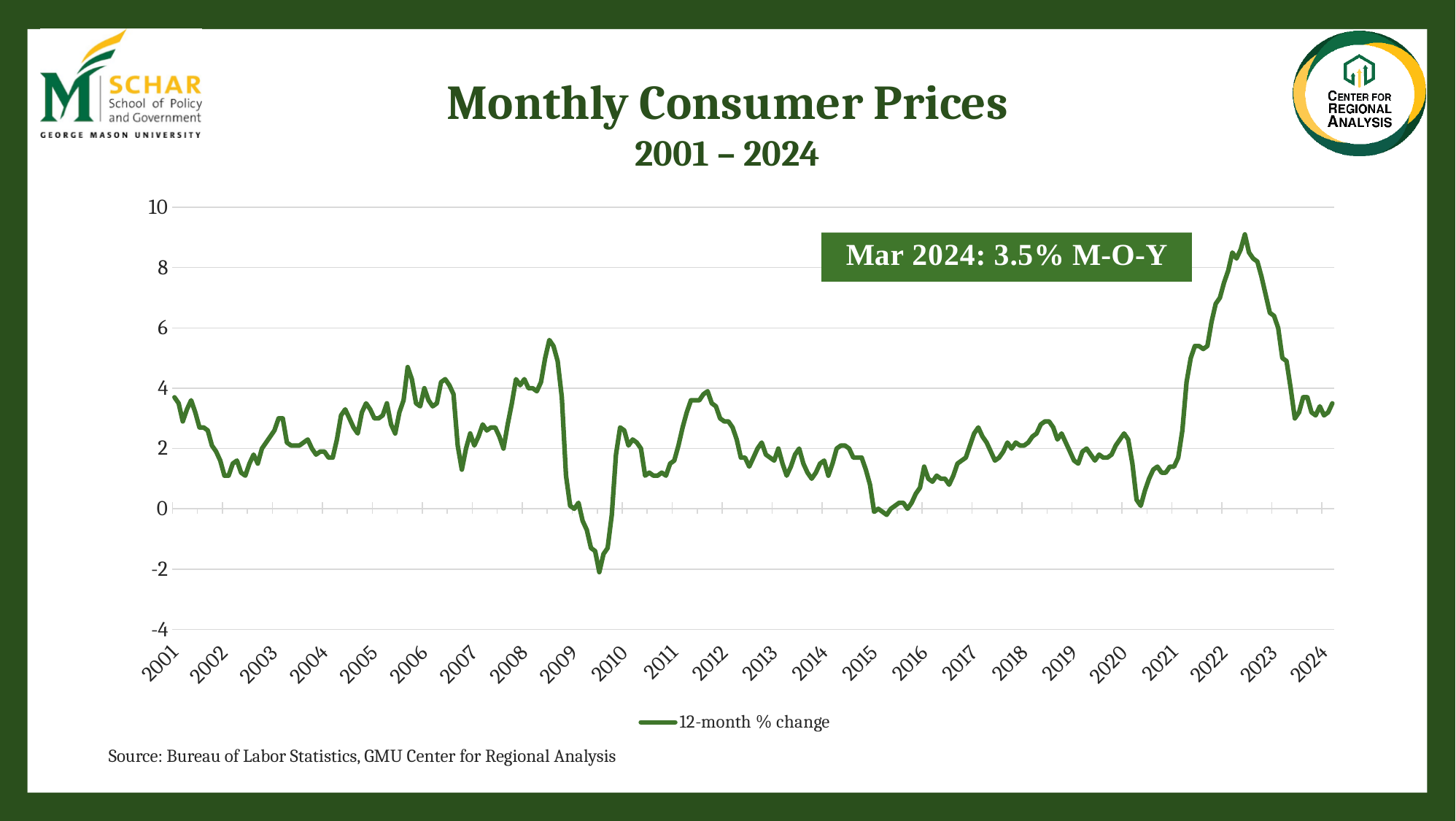
In which year does the 12-month % change reach its lowest point? 2009 Is the peak value of the line in 2022 greater or less than 8? greater In which year does the 12-month % change reach its highest point? 2022 What is the title of the chart? Monthly Consumer Prices 2001 – 2024 Is the value at the start of 2001 greater or less than 2? greater How many series does the legend list? 1 What is the 12-month % change for March 2024 according to the callout on the chart? 3.5% Is the value at the end of 2023 greater or less than 6? less How many year labels are shown on the x axis? 24 What is the legend entry for the plotted line? 12-month % change What kind of chart is shown on the slide? line chart